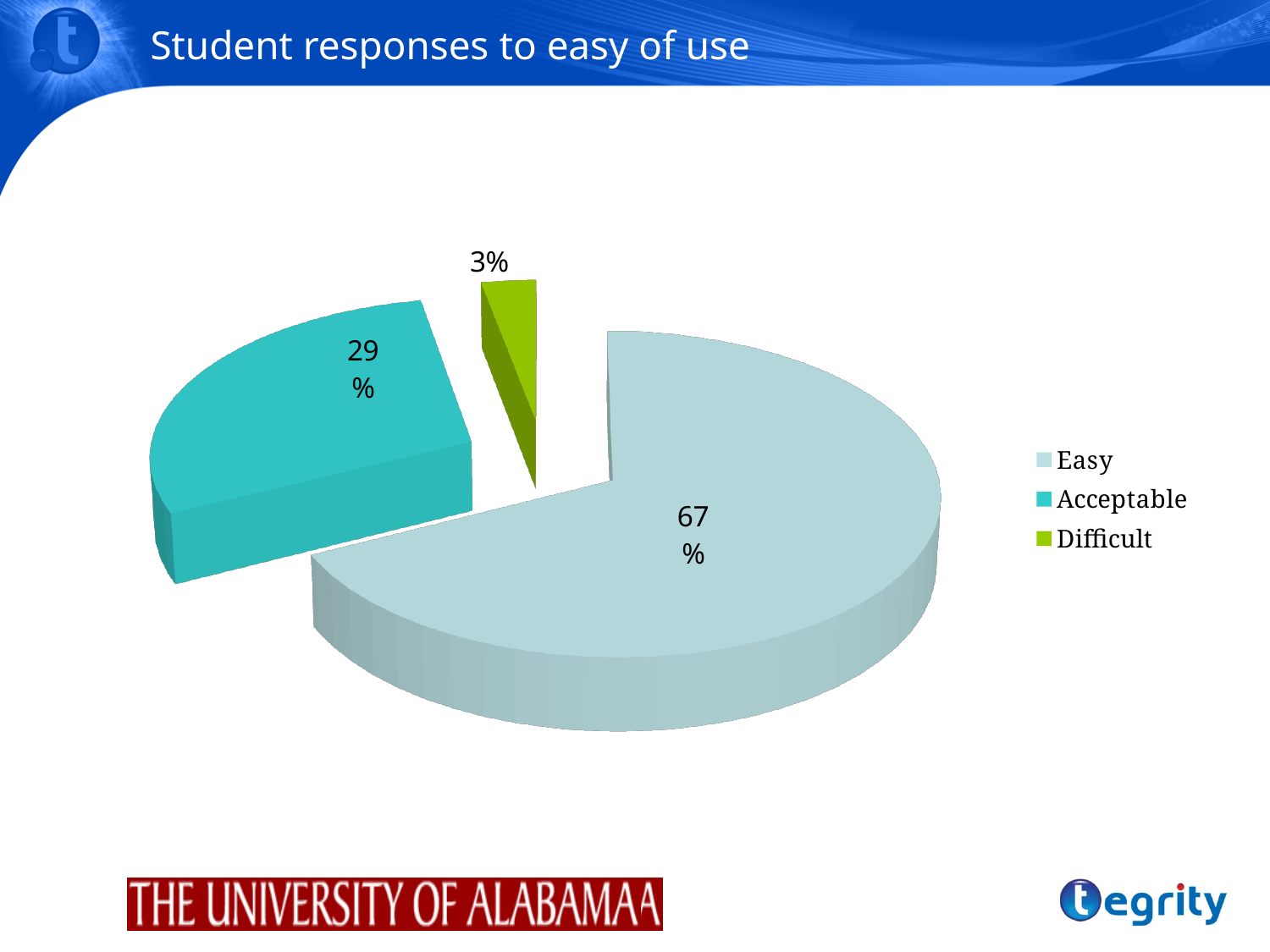
What kind of chart is shown on the slide? pie chart Which is larger, the Acceptable slice or the Difficult slice? Acceptable What is the difference in percentage points between the Easy and Acceptable slices? 38 Which response category has the largest slice of the pie? Easy Which colour represents the Difficult category in the legend? green Which response category has the smallest slice of the pie? Difficult How many categories does the pie chart show? 3 What share of student responses is labelled Difficult? 3% What share of student responses is labelled Easy? 67% What share of student responses is labelled Acceptable? 29% What is the title of the slide containing the pie chart? Student responses to easy of use What is the difference in percentage points between the Acceptable and Difficult slices? 26